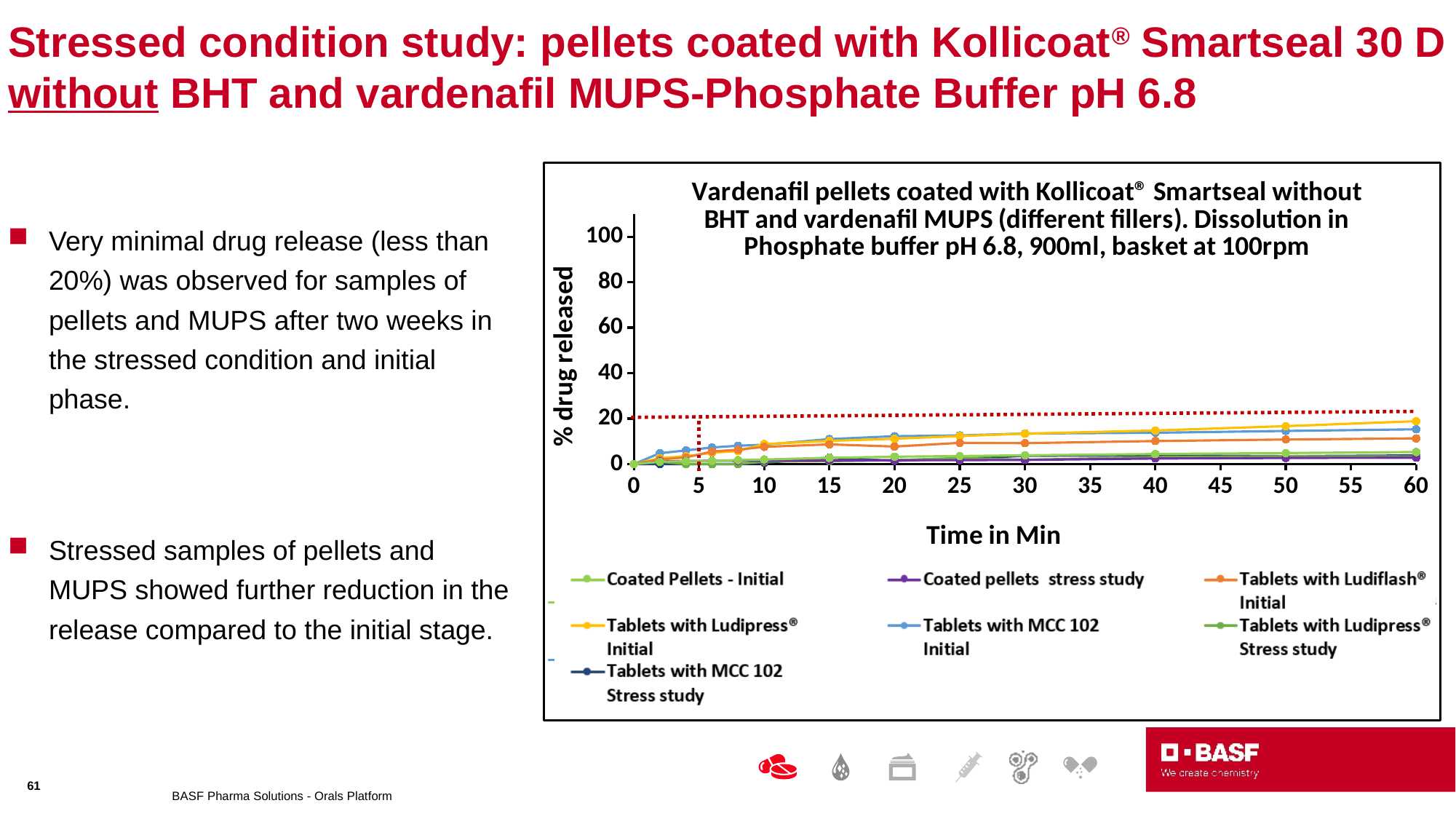
Does the value for Tablets with Ludipress® Initial rise or fall as time increases from 0 to 60 minutes? rise Is the value for Tablets with MCC 102 Initial at 60 minutes greater or less than 20? less Which series has the highest value at 60 minutes? Tablets with Ludipress® Initial What is the label of the x axis of the chart? Time in Min What is the highest value shown on the y axis of the chart? 100 At 60 minutes, which is larger: Tablets with Ludipress® Initial or Tablets with Ludipress® Stress study? Tablets with Ludipress® Initial Is the value for Coated pellets stress study at 60 minutes greater or less than 20? less What kind of chart is shown on the slide? line chart What is the label of the y axis of the chart? % drug released At 60 minutes, which is larger: Tablets with MCC 102 Initial or Tablets with MCC 102 Stress study? Tablets with MCC 102 Initial Is the value for Tablets with Ludipress® Initial at 60 minutes greater or less than 40? less How many series does the chart legend list? 7